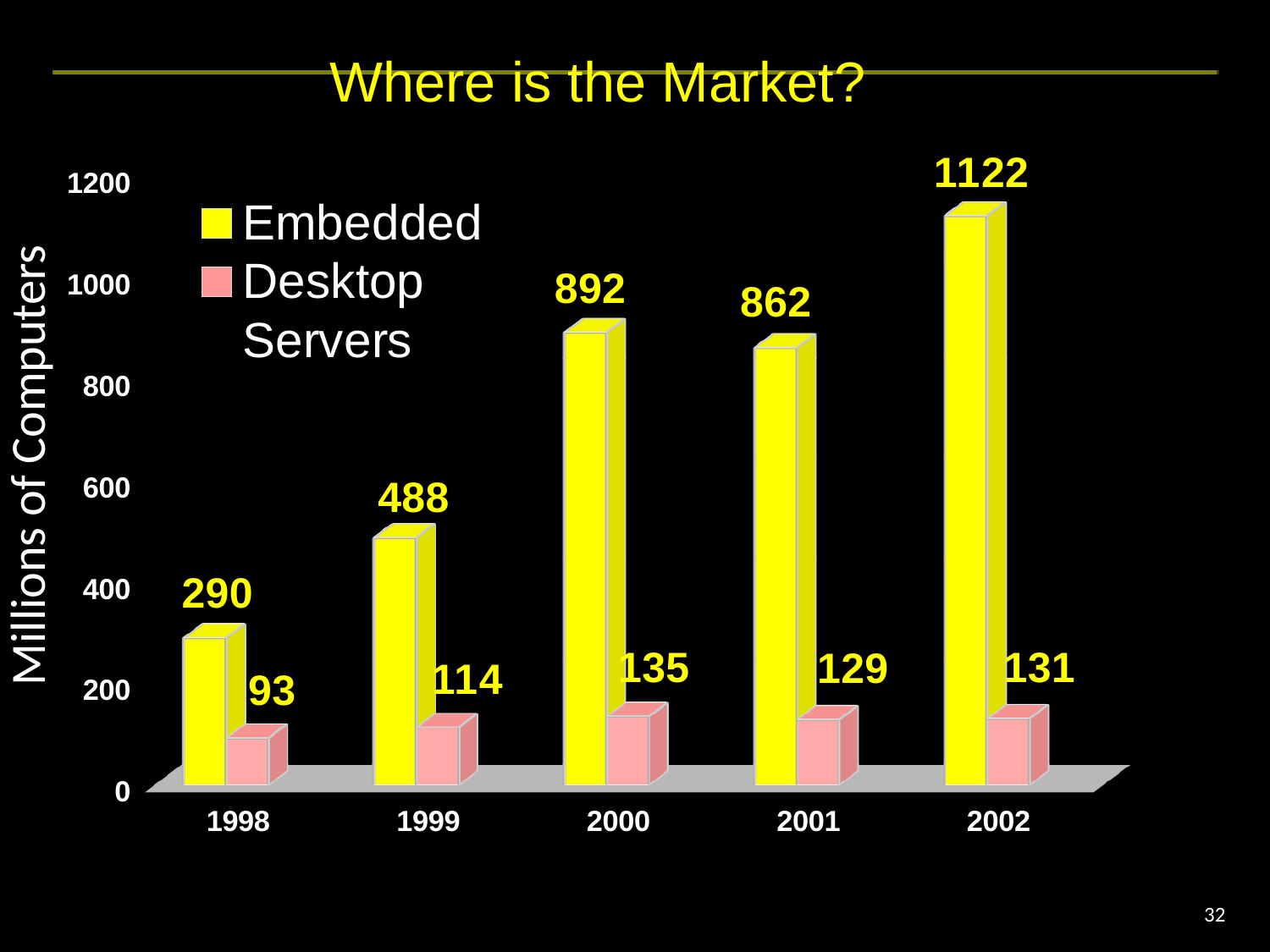
Is the Embedded value for 2001 greater or less than 800? greater Which year has the highest Embedded value? 2002 How many years are shown on the x axis? 5 What is the title of the chart? Where is the Market? How many series does the legend list? 3 What is the difference between the Embedded values for 2000 and 2001? 30 What kind of chart is shown on the slide? bar chart What is the Embedded value for 2002? 1122 What is the Embedded value for 1999? 488